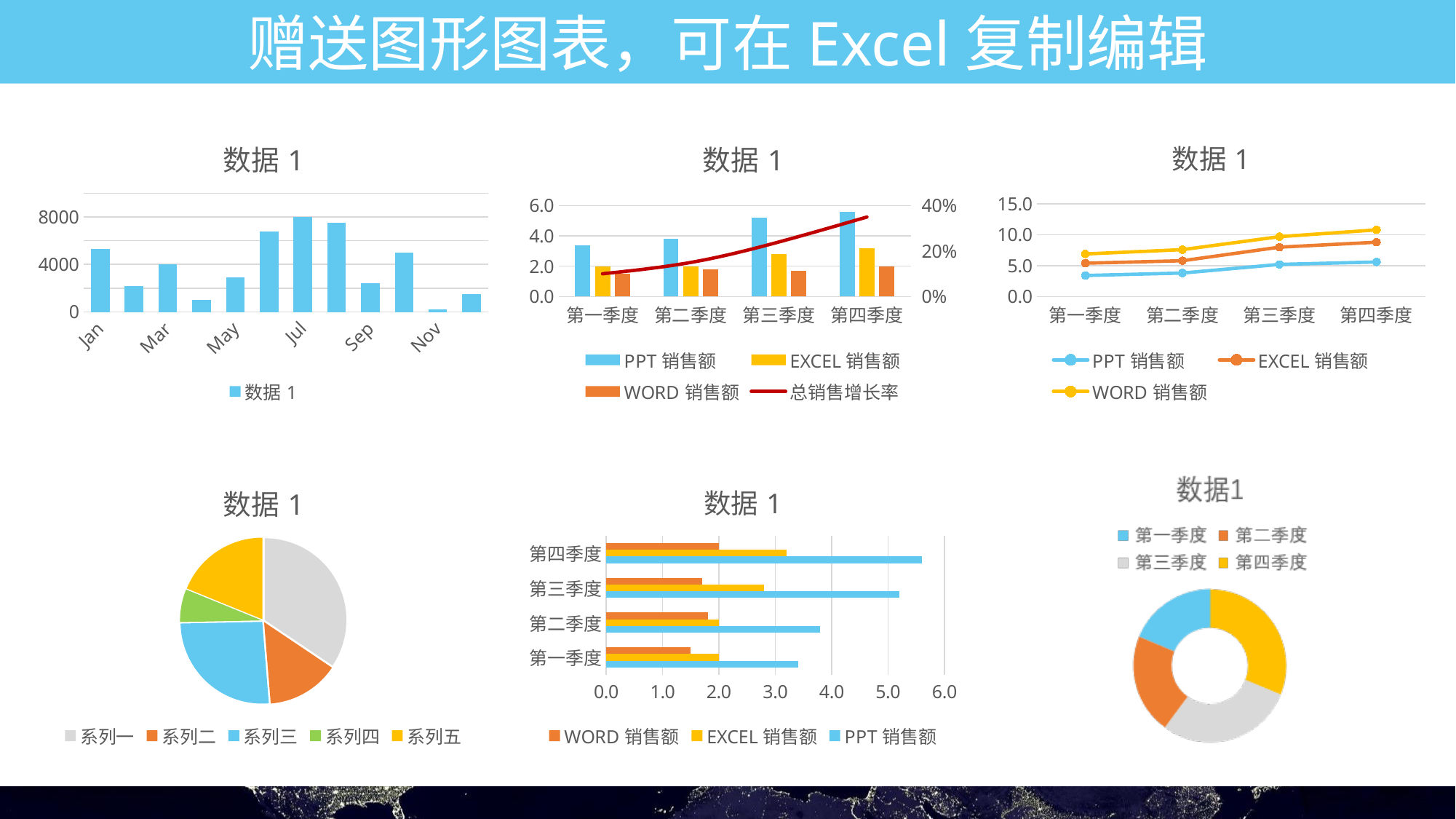
In the top-middle chart, is the PPT 销售额 value for 第三季度 greater or less than 4.0? greater In the top-right line chart, which series has the highest values across all four quarters? WORD 销售额 In the top-left bar chart, is the value for Jan greater or less than 4000? greater In the bottom-left pie chart, which series has the largest slice? 系列一 In the bottom-left pie chart, which series has the smallest slice? 系列四 In the top-middle chart, which quarter has the highest PPT 销售额 bar? 第四季度 What kind of chart is the top-left chart on the slide? bar chart In the top-right line chart, do the PPT 销售额 values rise or fall from 第一季度 to 第四季度? rise In the top-middle chart, how many series does the legend list? 4 In the bottom-middle horizontal bar chart, is the PPT 销售额 value for 第四季度 greater or less than 5.0? greater In the top-left bar chart, how many bars (months) are plotted? 12